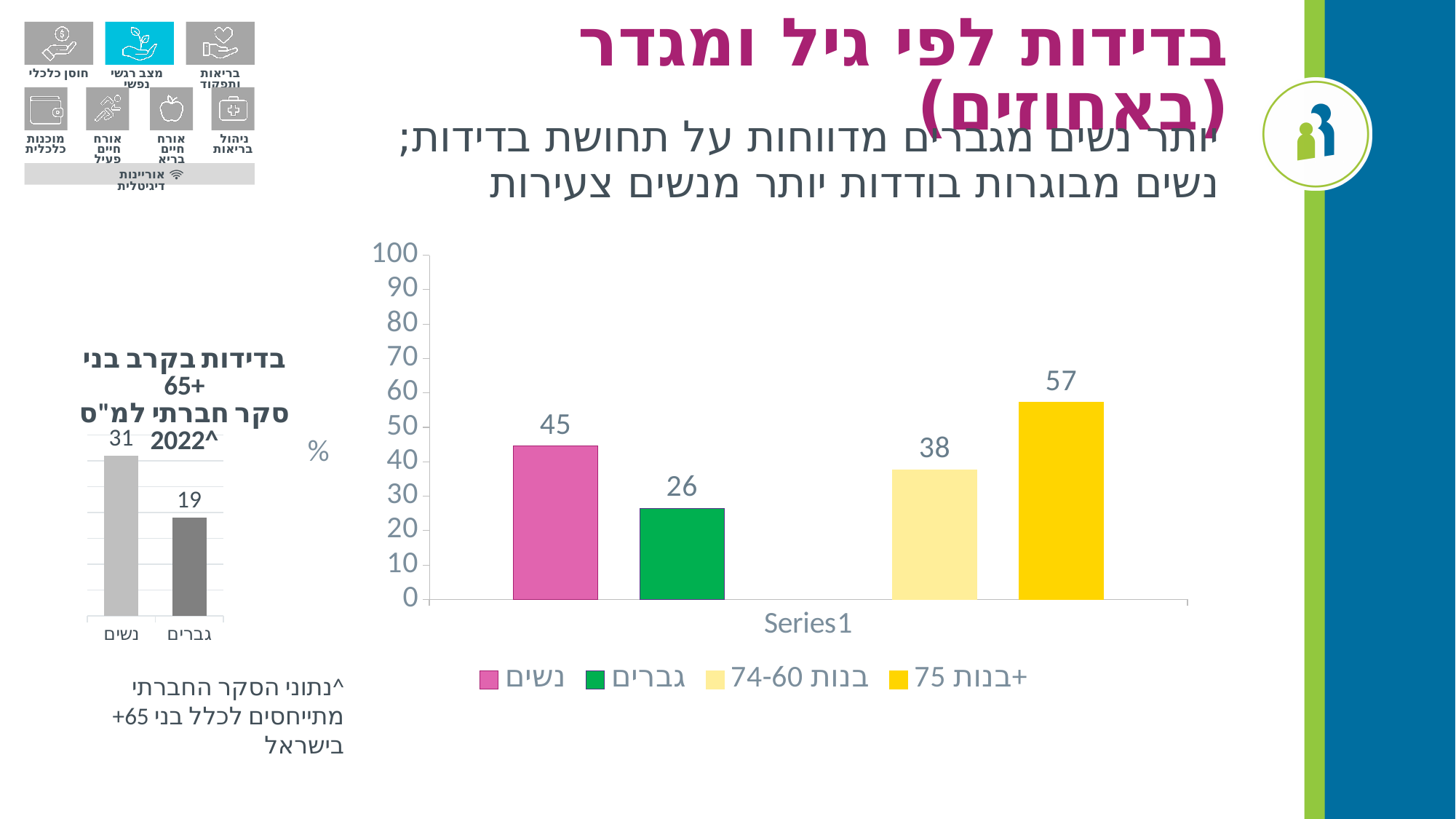
What kind of chart is the large chart on the right? bar chart In the large chart on the right, which legend entry has the highest value? בנות 75+ In the large chart on the right, what is the value for נשים? 45 In the large chart on the right, what is the difference between the values for בנות 75+ and בנות 60-74? 19 In the large chart on the right, which legend entry has the lowest value? גברים In the large chart on the right, what colour is the bar for גברים? green In the small chart on the left titled 'בדידות בקרב בני 65+', what is the value for נשים? 31 In the large chart on the right, which is larger: the value for נשים or the value for בנות 60-74? נשים How many entries does the legend of the large chart on the right list? 4 In the small chart on the left titled 'בדידות בקרב בני 65+', what is the difference between the values for נשים and גברים? 12 In the large chart on the right, what is the value for בנות 75+? 57 In the large chart on the right, what is the value for גברים? 26